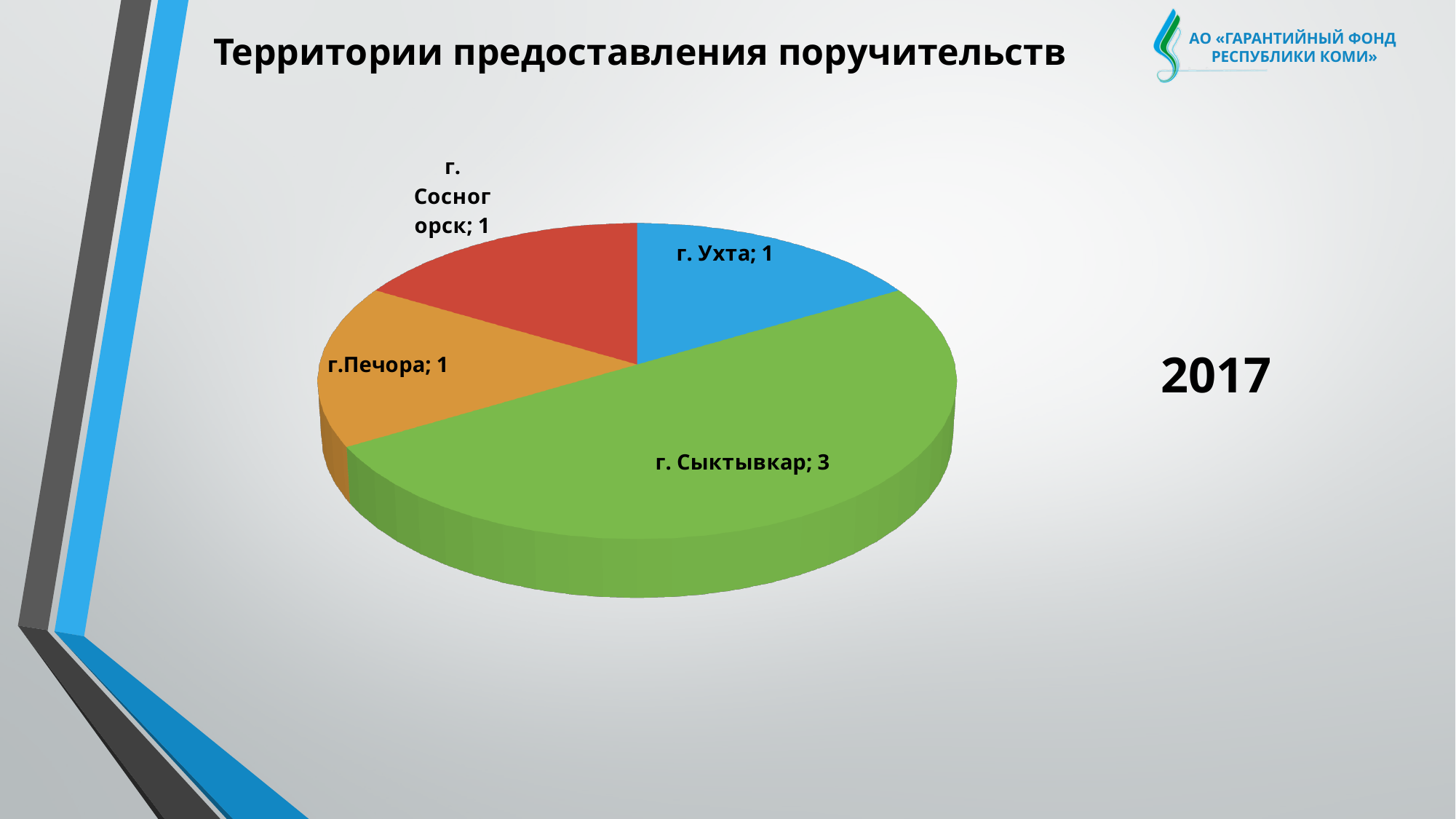
What share of the pie does г. Сыктывкар represent? 50% How many categories are shown in the pie chart? 4 What is the value for г.Печора? 1 What is the title of the chart on the slide? Территории предоставления поручительств What year is shown next to the chart? 2017 What type of chart is shown on the slide? Pie chart Which category has the largest slice of the pie? г. Сыктывкар What is the value for г. Сосногорск? 1 What is the difference between the values for г. Сыктывкар and г. Ухта? 2 What is the value for г. Сыктывкар? 3 What is the value for г. Ухта? 1 Which is larger, the value for г. Сыктывкар or the value for г.Печора? г. Сыктывкар